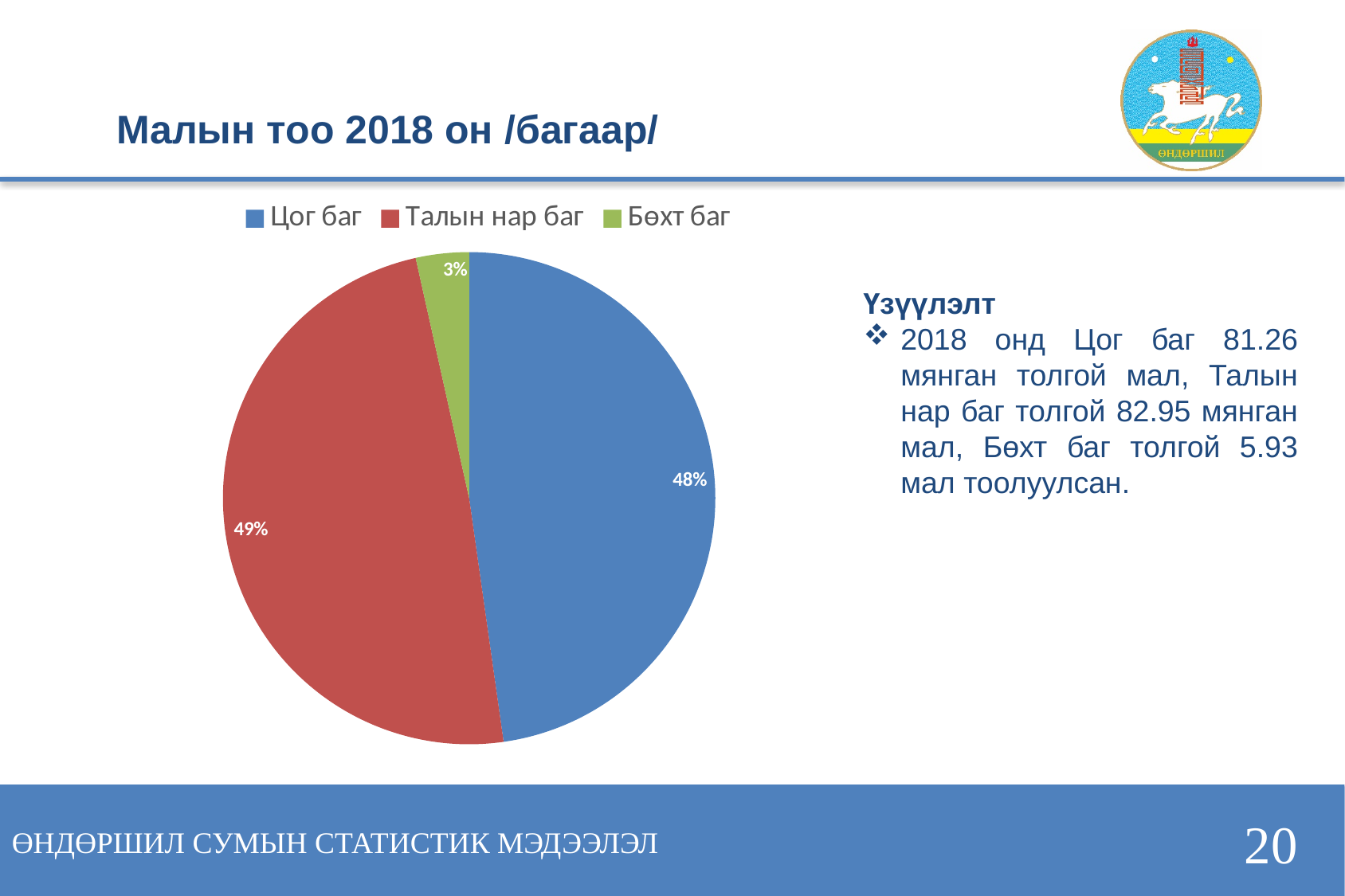
What colour is the slice for Бөхт баг? green How many entries does the legend of the pie chart list? 3 What kind of chart is shown on the slide? pie chart How many slices does the pie chart have? 3 What is the difference in percentage points between the Талын нар баг slice and the Цог баг slice? 1% What share of the pie does Бөхт баг have? 3% Which category has the smallest slice of the pie? Бөхт баг What share of the pie does Талын нар баг have? 49% What share of the pie does Цог баг have? 48% Which legend entry is shown in red? Талын нар баг Which category has the largest slice of the pie? Талын нар баг Which slice is larger, Цог баг or Бөхт баг? Цог баг